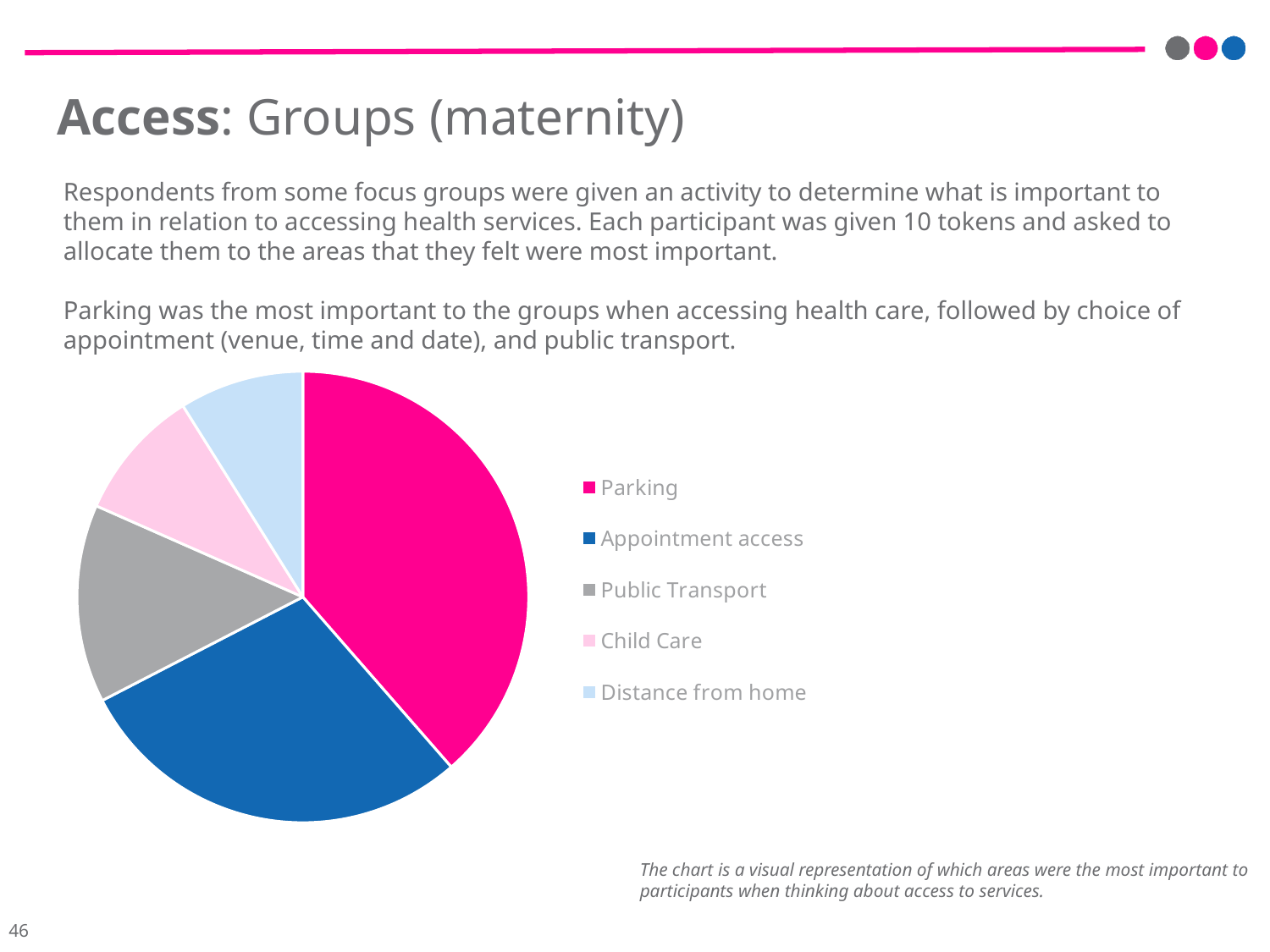
How many categories (slices) does the pie chart have? 5 How many entries does the legend of the pie chart list? 5 Which is larger in the pie chart, Appointment access or Public Transport? Appointment access Which is larger in the pie chart, Public Transport or Child Care? Public Transport Which is larger in the pie chart, Parking or Public Transport? Parking Which category has the second-largest slice in the pie chart? Appointment access Which category has the largest slice in the pie chart? Parking What kind of chart is shown on the slide? Pie chart What colour is the Parking slice in the pie chart? Pink (magenta)